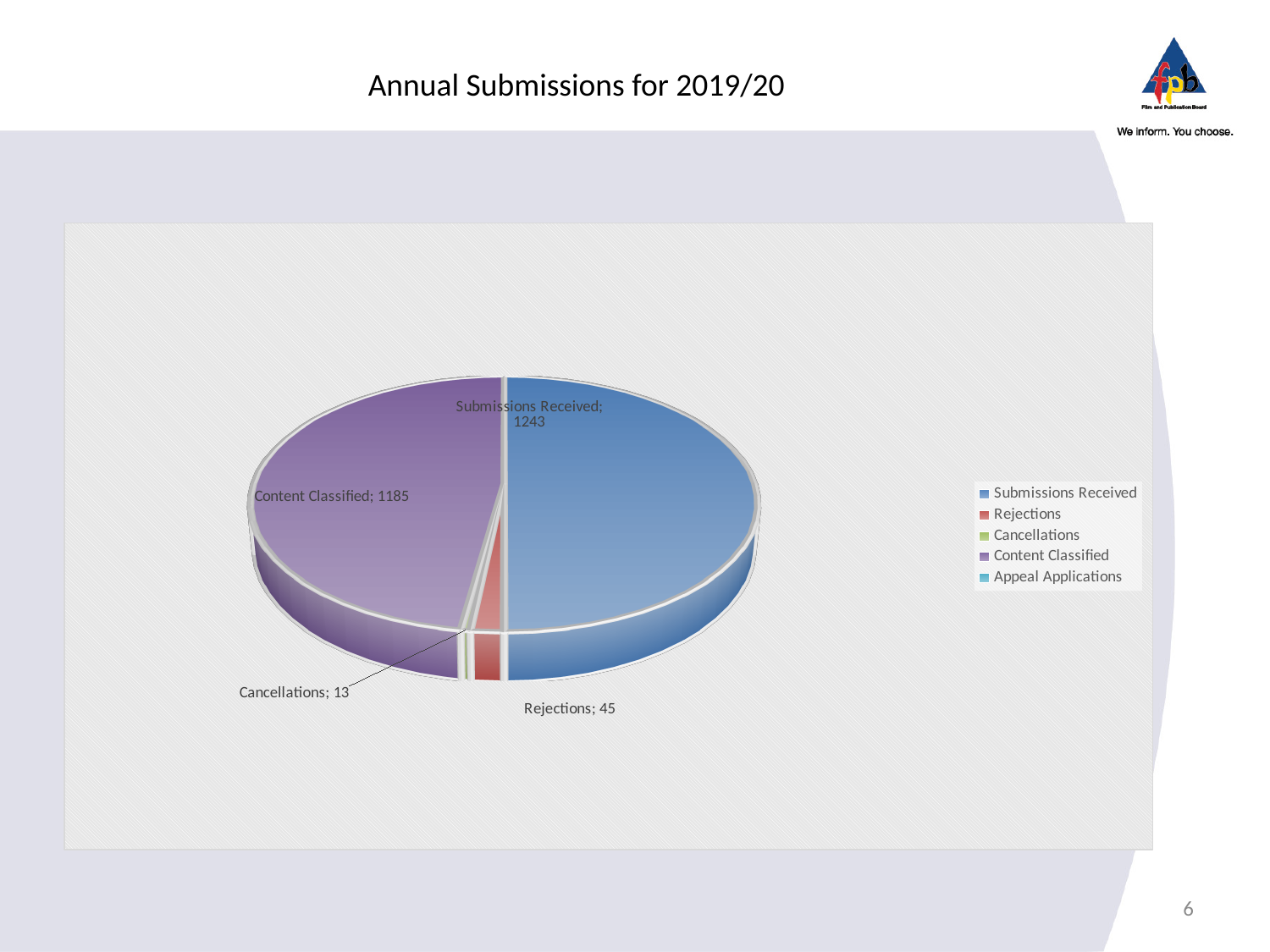
What is the difference between Submissions Received and Content Classified? 58 What value is shown for Rejections? 45 Which category has the largest slice of the pie? Submissions Received What value is shown for Content Classified? 1185 Which labelled category has the smallest value? Cancellations What kind of chart is shown on the slide? Pie chart Which is larger, Rejections or Cancellations? Rejections What is the title of the slide? Annual Submissions for 2019/20 What value is shown for Submissions Received? 1243 What is the difference between Rejections and Cancellations? 32 What value is shown for Cancellations? 13 How many entries does the legend list? 5